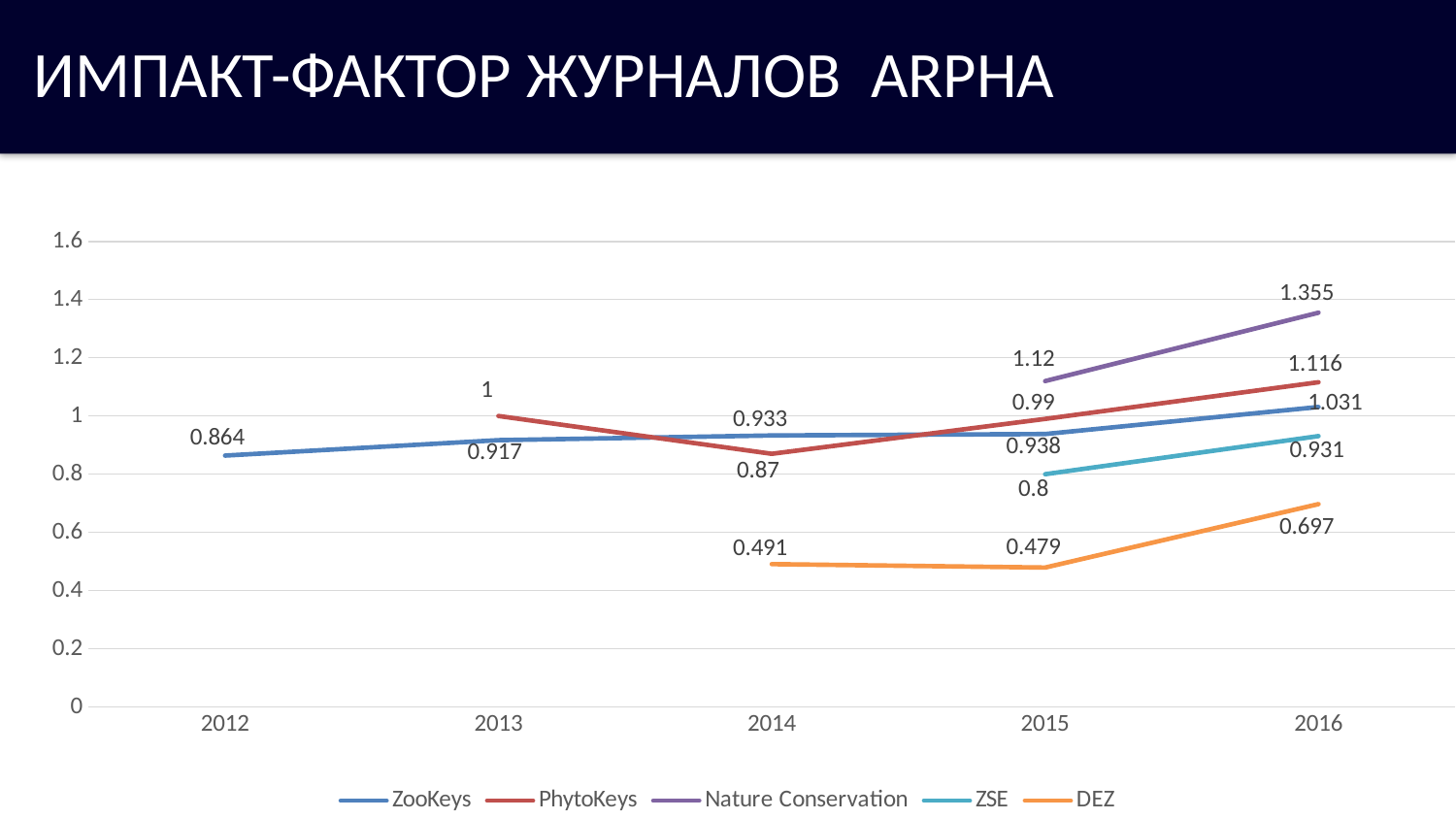
How many years are shown on the x axis? 5 Which journal has the highest impact factor in 2016? Nature Conservation By how much did the Nature Conservation value increase from 2015 to 2016? 0.235 What kind of chart is shown on the slide? line chart In 2014, which is larger: the value for ZooKeys or for PhytoKeys? ZooKeys What is the impact factor of ZooKeys in 2012? 0.864 What is the value for DEZ in 2015? 0.479 What is the value for ZSE in 2015? 0.8 What is the value for Nature Conservation in 2016? 1.355 Which journal has the lowest impact factor in 2016? DEZ How many series does the legend list? 5 Does the ZooKeys line rise or fall from 2012 to 2016? rises